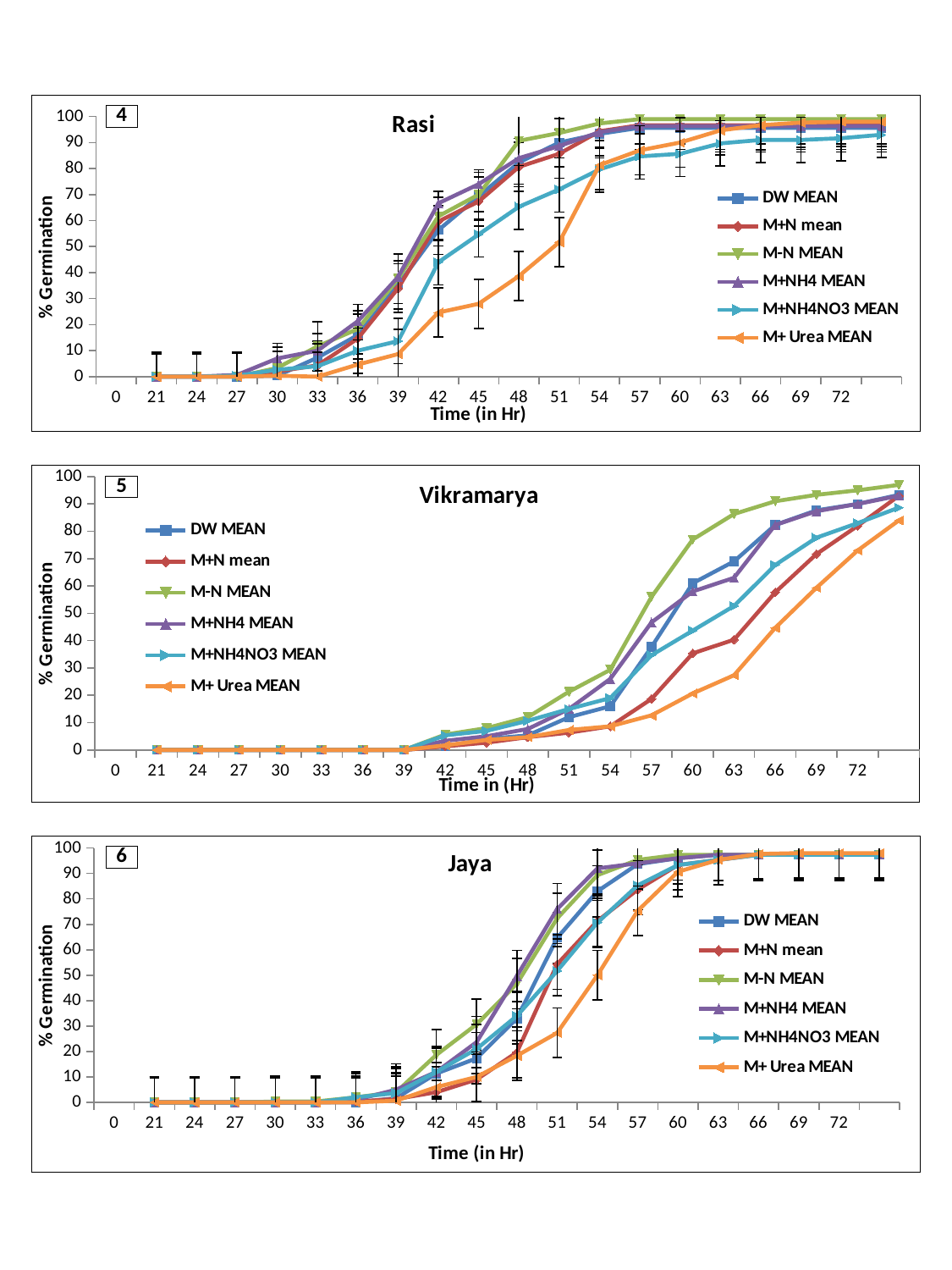
In the Jaya chart, which series has the lowest value at 54 hours? M+ Urea MEAN What is the y-axis label of the Rasi chart? % Germination In the Vikramarya chart, which series has the highest value at 72 hours? M-N MEAN In the Vikramarya chart, is the value for M-N MEAN at 60 hours greater or less than 70? greater In the Vikramarya chart, which series has the lowest value at 72 hours? M+ Urea MEAN What kind of chart is the Rasi chart? line chart In the Rasi chart, is the value for M-N MEAN at 48 hours greater or less than 80? greater In the Jaya chart, is the value for M+NH4 MEAN at 51 hours greater or less than 70? greater How many series does the legend of the Vikramarya chart list? 6 In the Jaya chart, do the germination values rise or fall as time increases along the x axis? rise In the Vikramarya chart at 60 hours, which is larger: M-N MEAN or M+ Urea MEAN? M-N MEAN